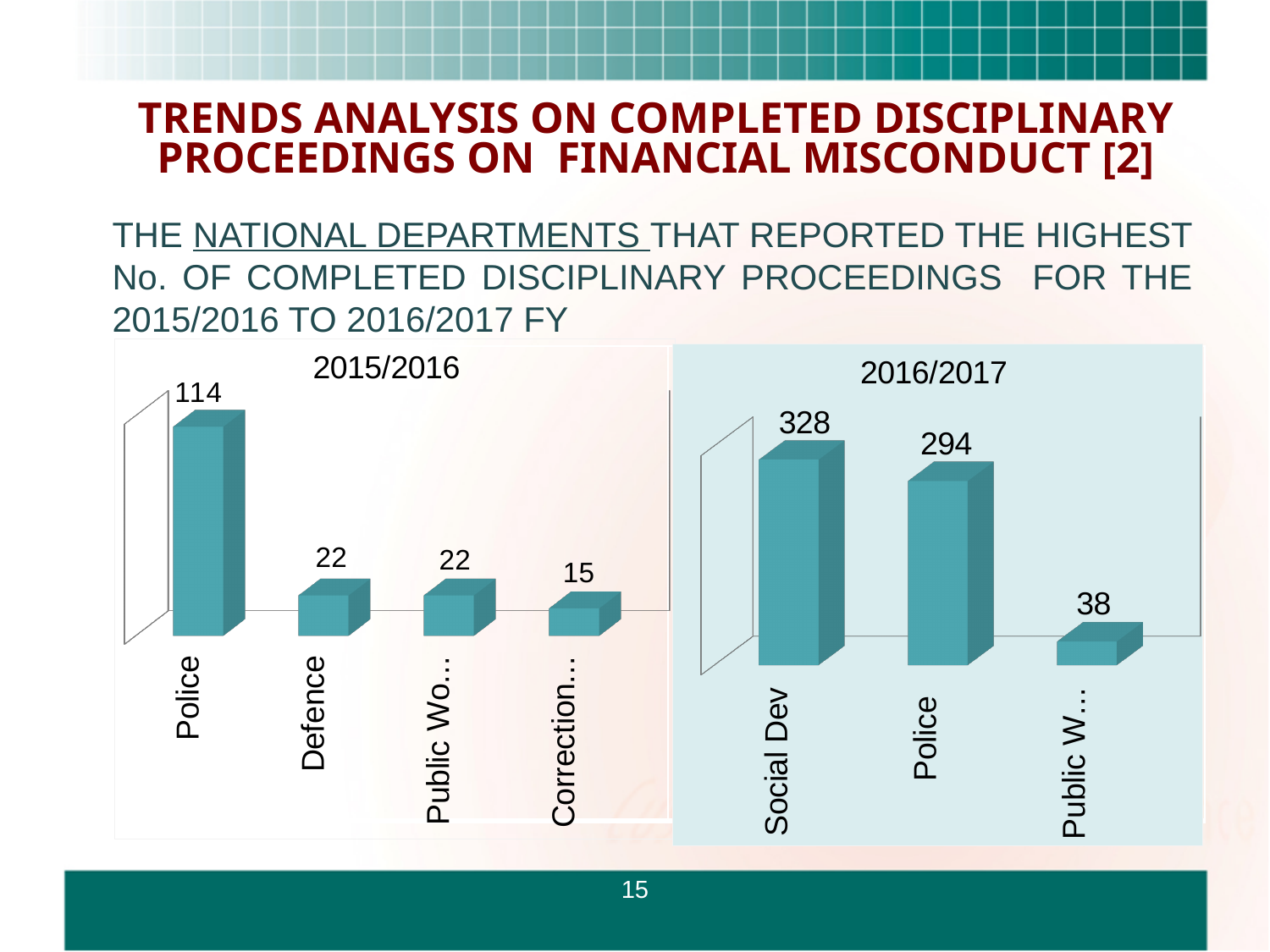
In the 2015/2016 chart, which department has the highest value? Police In the 2015/2016 chart, which is larger, the value for Police or the value for Defence? Police In the 2016/2017 chart, which department has the highest value? Social Dev In the 2015/2016 chart, what is the value for Police? 114 In the 2016/2017 chart, what is the difference between the values for Social Dev and Police? 34 How many bars are shown in the 2015/2016 chart? 4 In the 2015/2016 chart, what is the value for Defence? 22 How much higher is the value for Police in the 2016/2017 chart than in the 2015/2016 chart? 180 How many bars are shown in the 2016/2017 chart? 3 In the 2016/2017 chart, what is the value for Police? 294 What type of chart is the 2016/2017 chart? Bar chart In the 2016/2017 chart, what is the value for Social Dev? 328